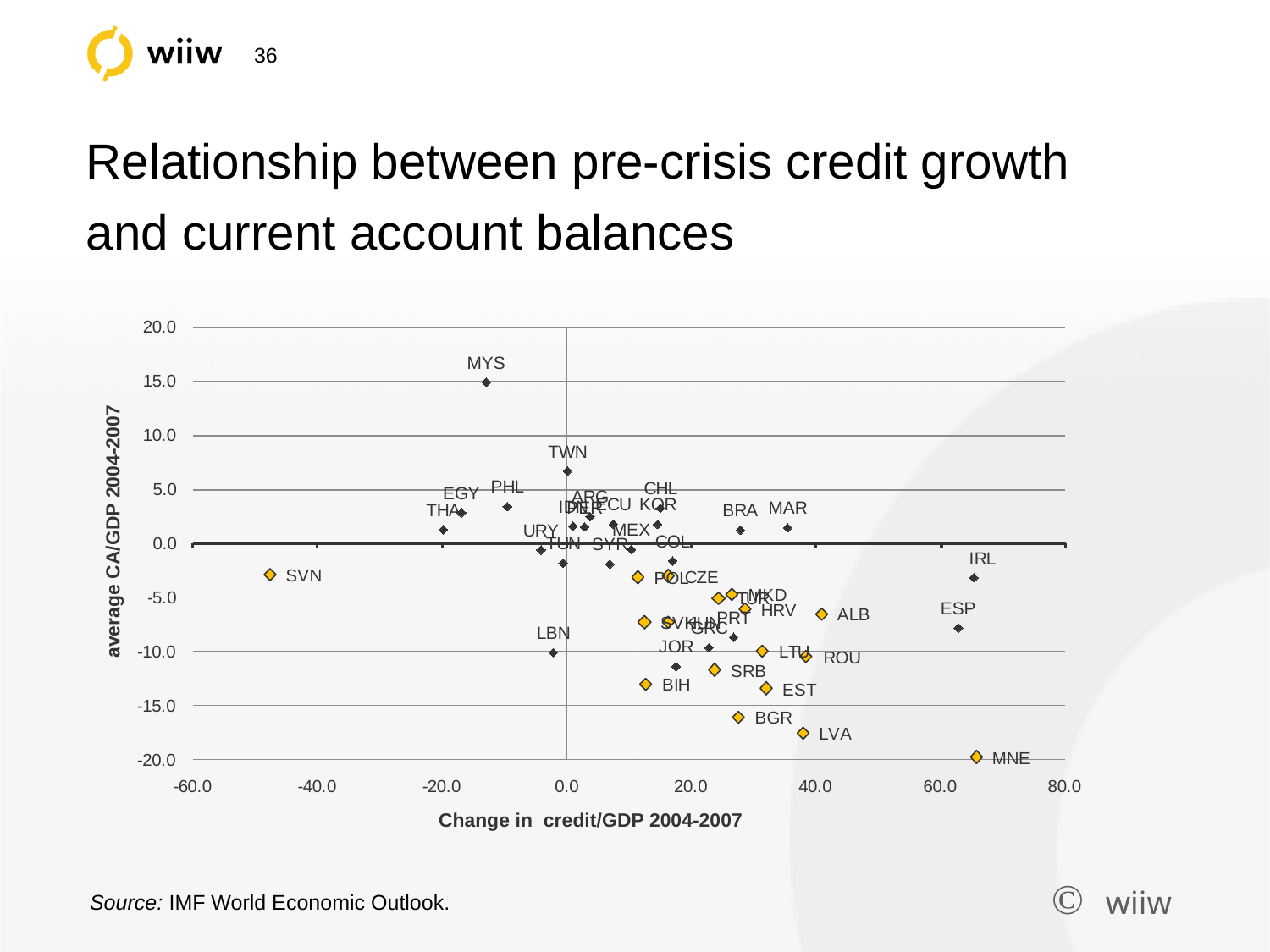
Which country has the lowest average CA/GDP 2004-2007 in the chart? MNE Which has a higher average CA/GDP 2004-2007, BIH or LVA? BIH Is the change in credit/GDP for SVN greater or less than -40.0? less Is the change in credit/GDP for IRL greater or less than 60.0? greater What kind of chart is shown on the slide? scatter chart Which country has the highest average CA/GDP 2004-2007 in the chart? MYS Is the average CA/GDP for MYS greater or less than 10.0? greater What is the label of the horizontal axis of the chart? Change in credit/GDP 2004-2007 Which has a higher average CA/GDP 2004-2007, MYS or TWN? MYS Which country has the lowest (most negative) change in credit/GDP 2004-2007? SVN